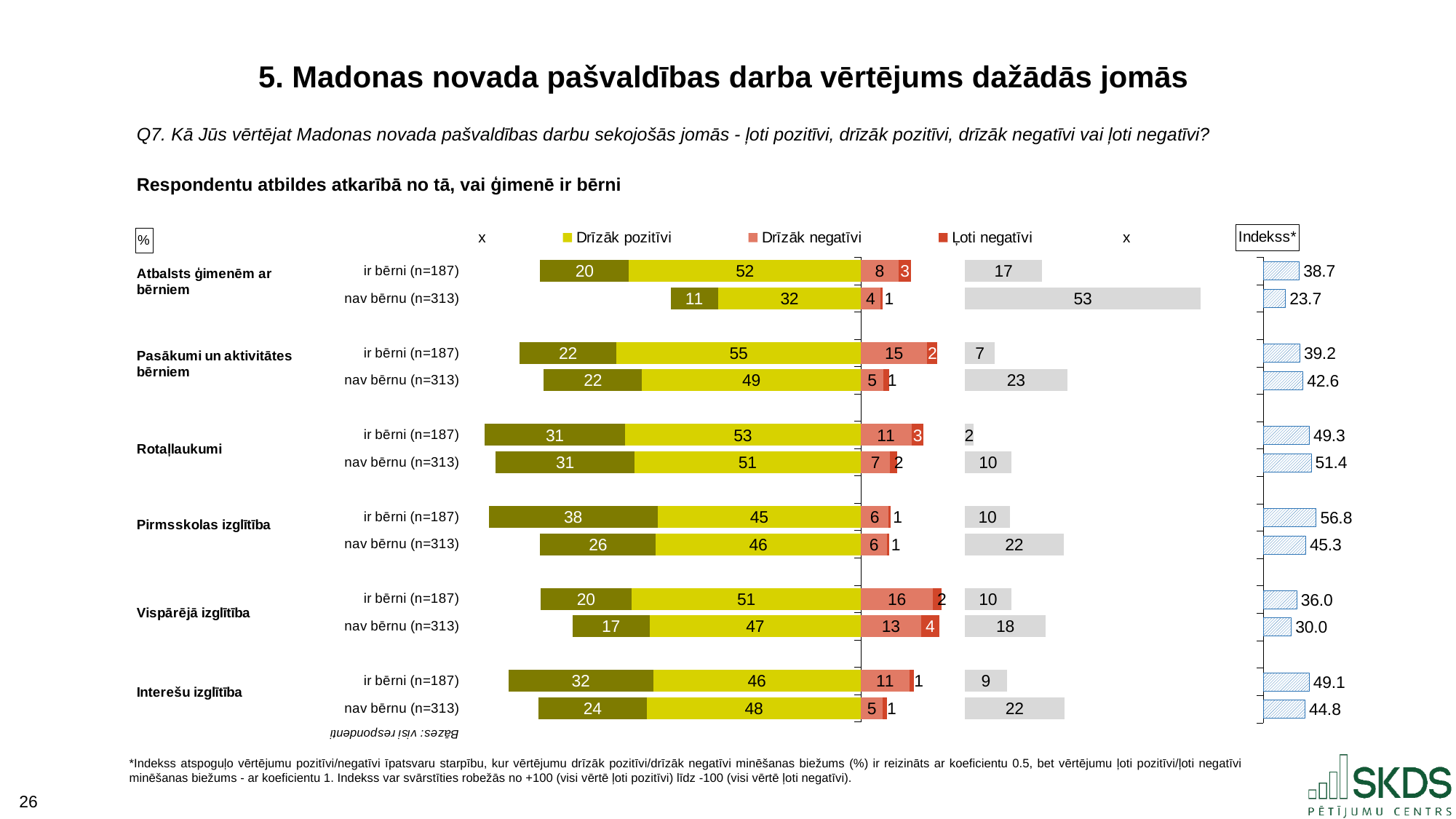
In the 'Indekss*' chart on the right, which row has the highest index value? Pirmsskolas izglītība, ir bērni (56.8) In the stacked bar chart, for 'Rotaļlaukumi', which group has the larger 'Drīzāk pozitīvi' value: ir bērni or nav bērnu? ir bērni In the 'Indekss*' chart on the right, which row has the lowest index value? Atbalsts ģimenēm ar bērniem, nav bērnu (23.7) How many areas (categories) of municipal work are evaluated in the stacked bar chart? 6 In the stacked bar chart, what is the difference between the 'Drīzāk negatīvi' values for 'Vispārējā izglītība' among respondents with children (16) and without children (13)? 3 In the stacked bar chart, what is the 'Drīzāk negatīvi' value for 'Vispārējā izglītība' among respondents with children (ir bērni)? 16 What kind of chart is used to show the respondents' answers on this slide? Stacked bar chart In the stacked bar chart, what is the value of the grey segment for 'Atbalsts ģimenēm ar bērniem' among respondents without children (nav bērnu)? 53 In the stacked bar chart, what is the 'Ļoti negatīvi' value for 'Vispārējā izglītība' among respondents without children (nav bērnu)? 4 In the stacked bar chart, what is the 'Drīzāk pozitīvi' value for 'Pasākumi un aktivitātes bērniem' among respondents with children (ir bērni)? 55 In the 'Indekss*' chart on the right, what is the index value for 'Pirmsskolas izglītība' among respondents with children (ir bērni)? 56.8 In the 'Indekss*' chart, what is the difference between the index for 'Atbalsts ģimenēm ar bērniem' among respondents with children (38.7) and without children (23.7)? 15.0